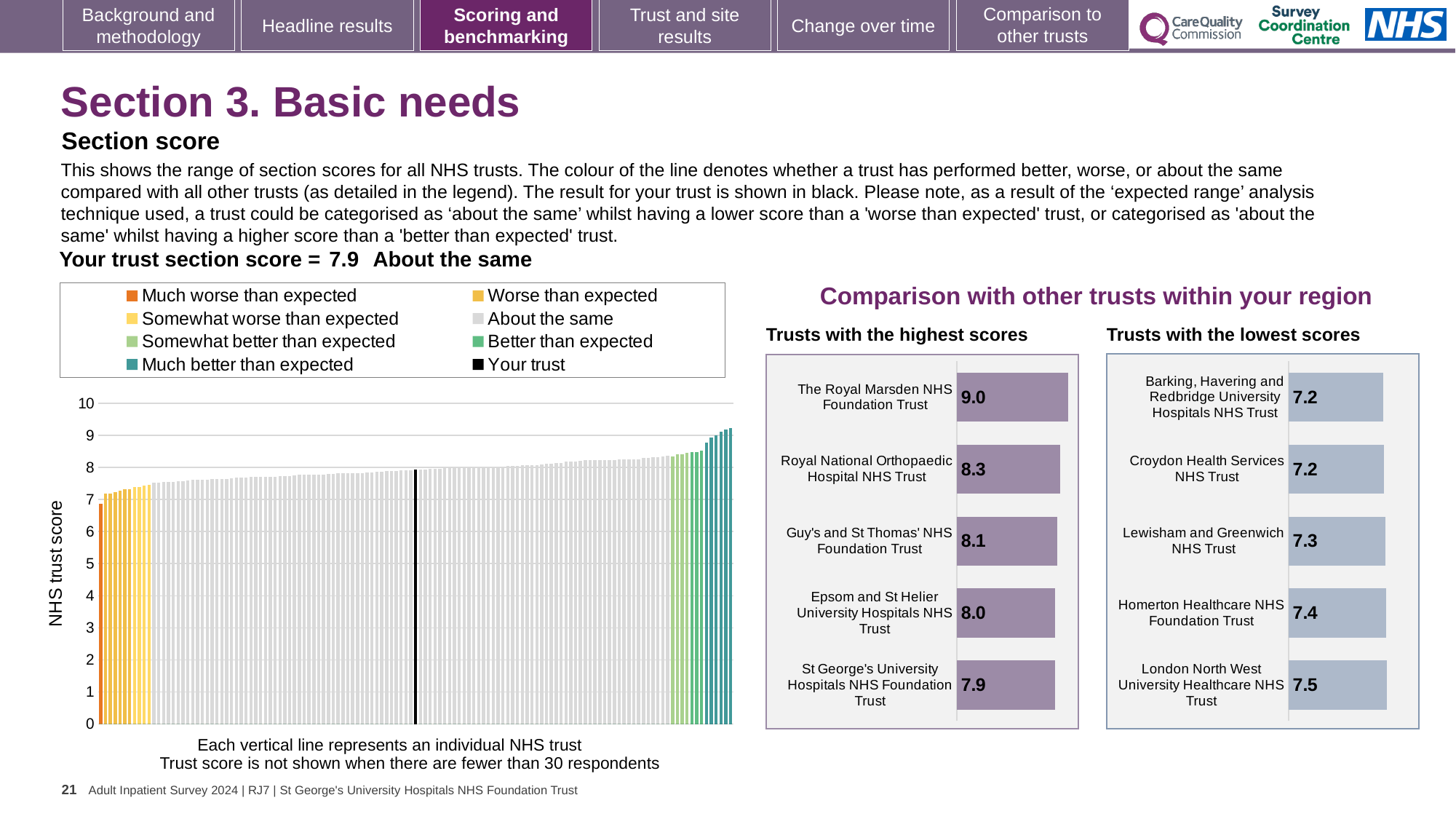
In the 'Trusts with the lowest scores' chart, which trust has the highest score? London North West University Healthcare NHS Trust How many trusts are shown in the 'Trusts with the highest scores' chart? 5 How many entries does the legend of the NHS trust score chart on the left list? 8 In the 'Trusts with the highest scores' chart, what is the difference between the scores of The Royal Marsden NHS Foundation Trust and St George's University Hospitals NHS Foundation Trust? 1.1 In the 'Trusts with the highest scores' chart, what is the score for The Royal Marsden NHS Foundation Trust? 9.0 In the NHS trust score chart on the left, is the value of the tallest bar greater or less than 9? greater What is the title above the two small bar charts on the right of the slide? Comparison with other trusts within your region In the 'Trusts with the lowest scores' chart, what is the score for Lewisham and Greenwich NHS Trust? 7.3 What kind of chart is the 'Trusts with the lowest scores' chart? bar chart In the 'Trusts with the lowest scores' chart, which has the larger score: Homerton Healthcare NHS Foundation Trust or Croydon Health Services NHS Trust? Homerton Healthcare NHS Foundation Trust In the NHS trust score chart on the left, do the values rise or fall from left to right along the x axis? rise In the 'Trusts with the highest scores' chart, which trust has the highest score? The Royal Marsden NHS Foundation Trust